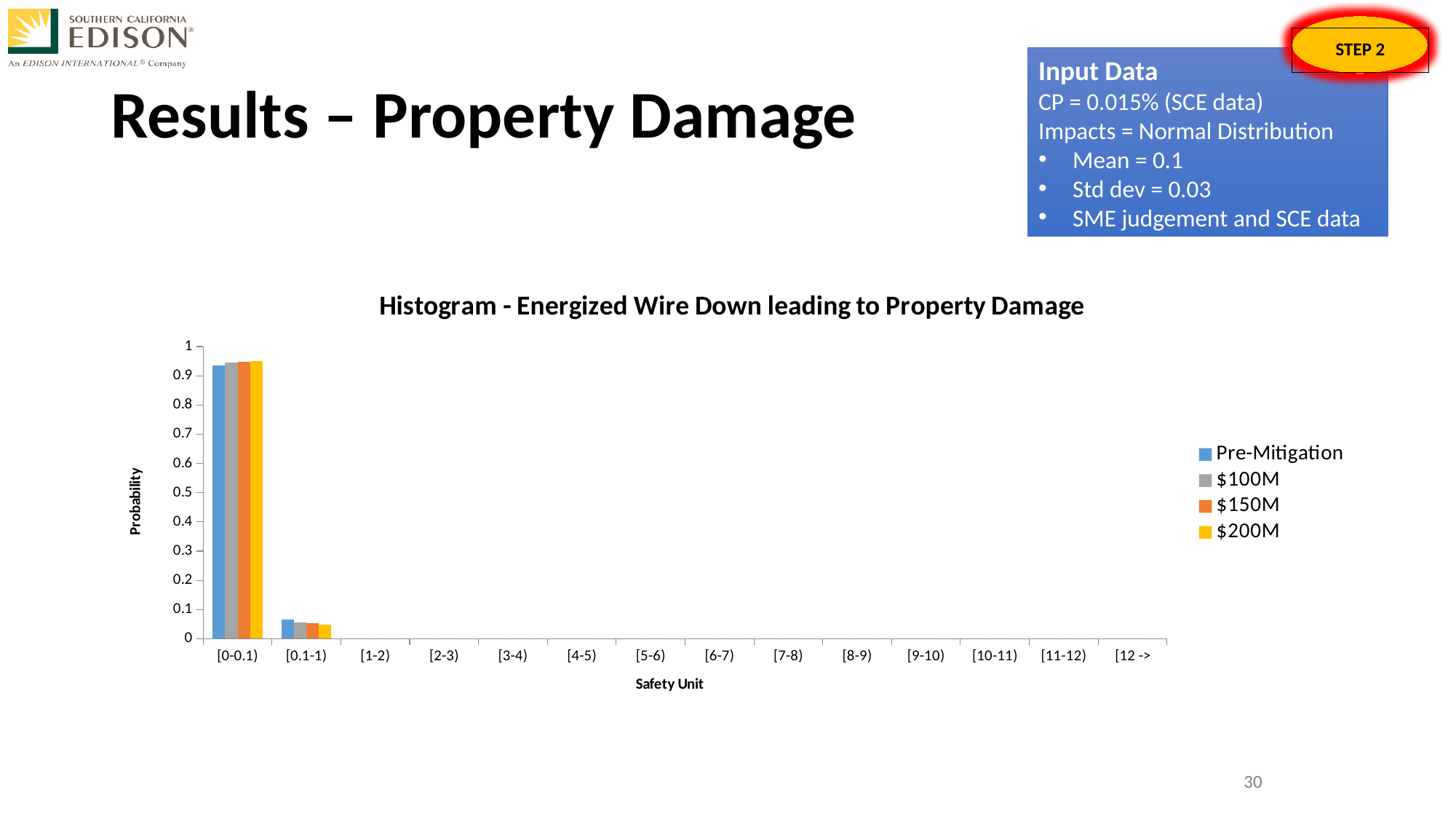
How many categories are shown on the x axis (Safety Unit)? 14 What kind of chart is shown on the slide? bar chart Do the probability values rise or fall moving from [0-0.1) to [0.1-1) along the x axis? fall What is the label of the y axis? Probability For the Pre-Mitigation series, which is larger: the value for [0-0.1) or the value for [0.1-1)? [0-0.1) Which Safety Unit category has the highest probability values? [0-0.1) Is the Pre-Mitigation value for [0-0.1) greater or less than 0.9? greater Is the $200M value for [0.1-1) greater or less than 0.1? less How many series does the legend list? 4 Is the $100M value for [0-0.1) greater or less than 0.5? greater What is the title of the chart? Histogram - Energized Wire Down leading to Property Damage